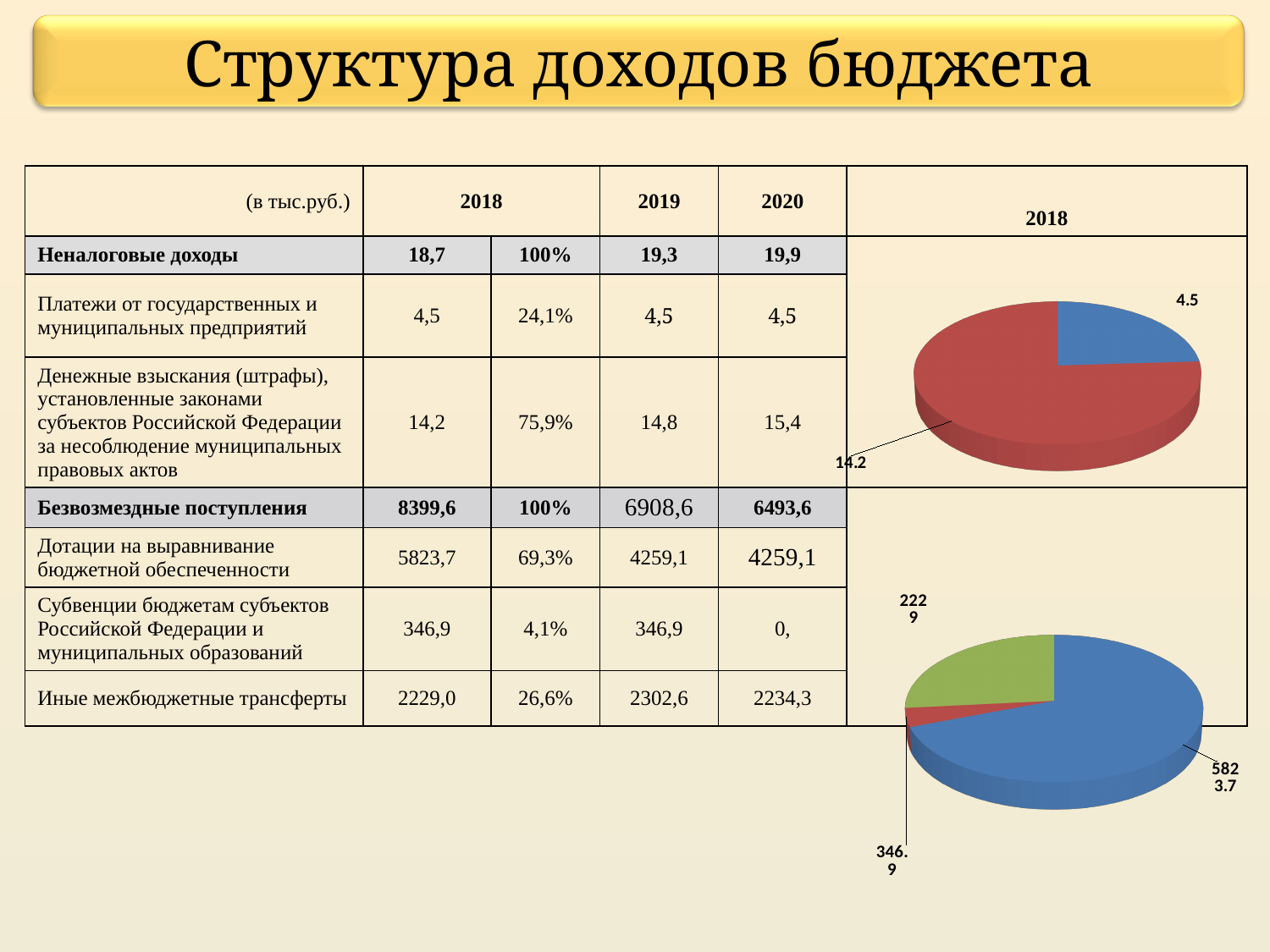
In the bottom pie chart, what value is labelled on the green slice? 2229 In the bottom pie chart, what value is labelled on the blue slice? 5823.7 In the top pie chart titled "2018", what value is labelled on the red slice? 14.2 In the top pie chart titled "2018", what value is labelled on the blue slice? 4.5 In the bottom pie chart, which slice is the smallest? the red slice (346.9) In the bottom pie chart, is the blue slice (5823.7) larger or smaller than the green slice (2229)? larger In the bottom pie chart, how many slices are there? 3 What is the title shown above the top pie chart? 2018 In the top pie chart titled "2018", how many slices are there? 2 What type of chart is the top chart titled "2018"? pie chart In the top pie chart titled "2018", what is the difference between the red slice (14.2) and the blue slice (4.5)? 9.7 In the top pie chart titled "2018", which slice is the largest? the red slice (14.2)